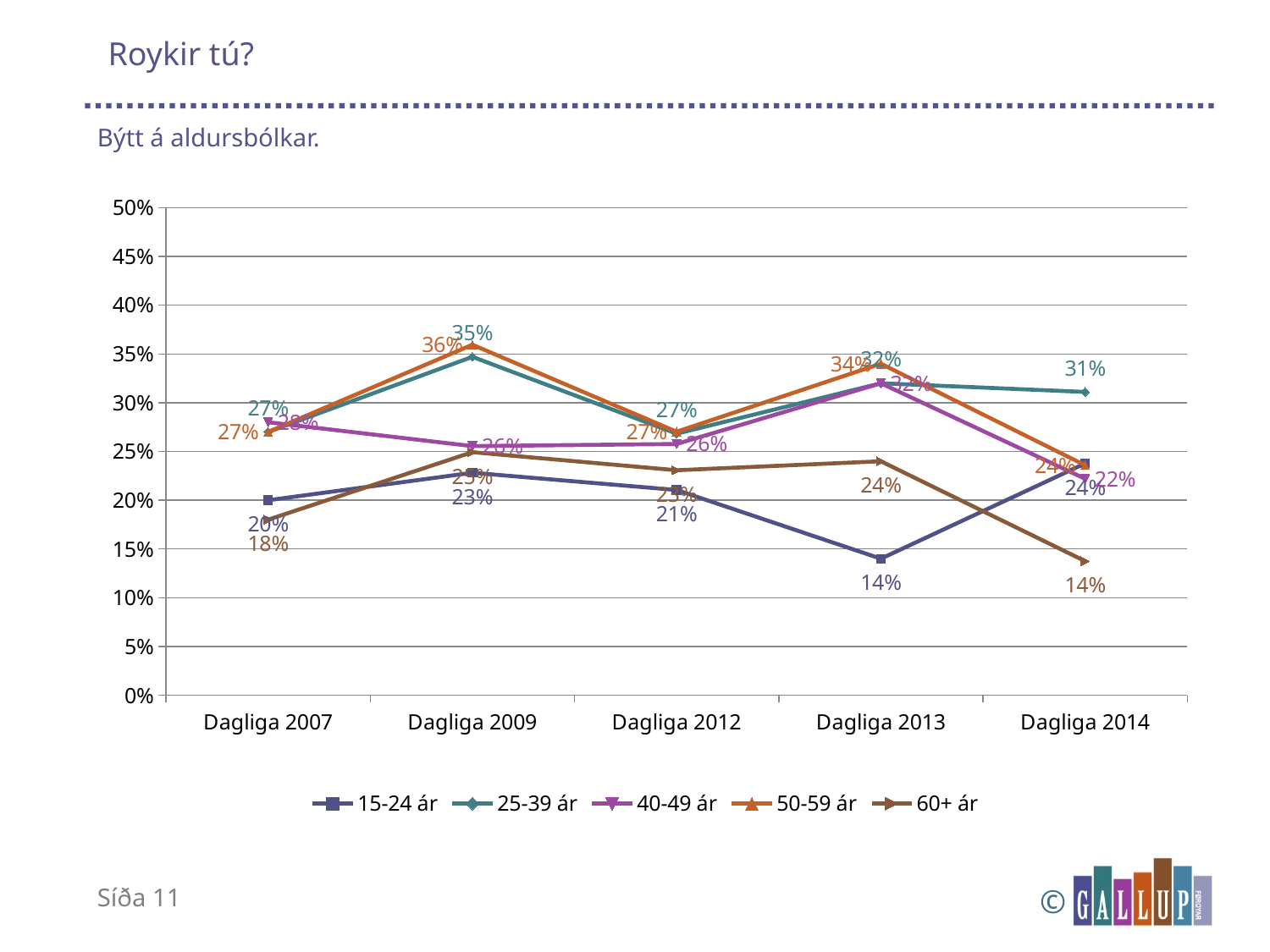
How many categories are shown on the x axis? 5 What kind of chart is shown on the slide? line chart What is the difference between the 15-24 ár values at Dagliga 2014 and Dagliga 2013? 10 percentage points How many series does the legend list? 5 Does the 60+ ár series rise or fall from Dagliga 2013 to Dagliga 2014? fall What is the value for 50-59 ár at Dagliga 2009? 36% What is the value for 25-39 ár at Dagliga 2014? 31% Is the value for 25-39 ár at Dagliga 2013 greater or less than 30%? greater What is the value for 60+ ár at Dagliga 2007? 18% What is the value for 15-24 ár at Dagliga 2013? 14% Which series has the highest value at Dagliga 2009? 50-59 ár At which category does the 15-24 ár series reach its lowest value? Dagliga 2013